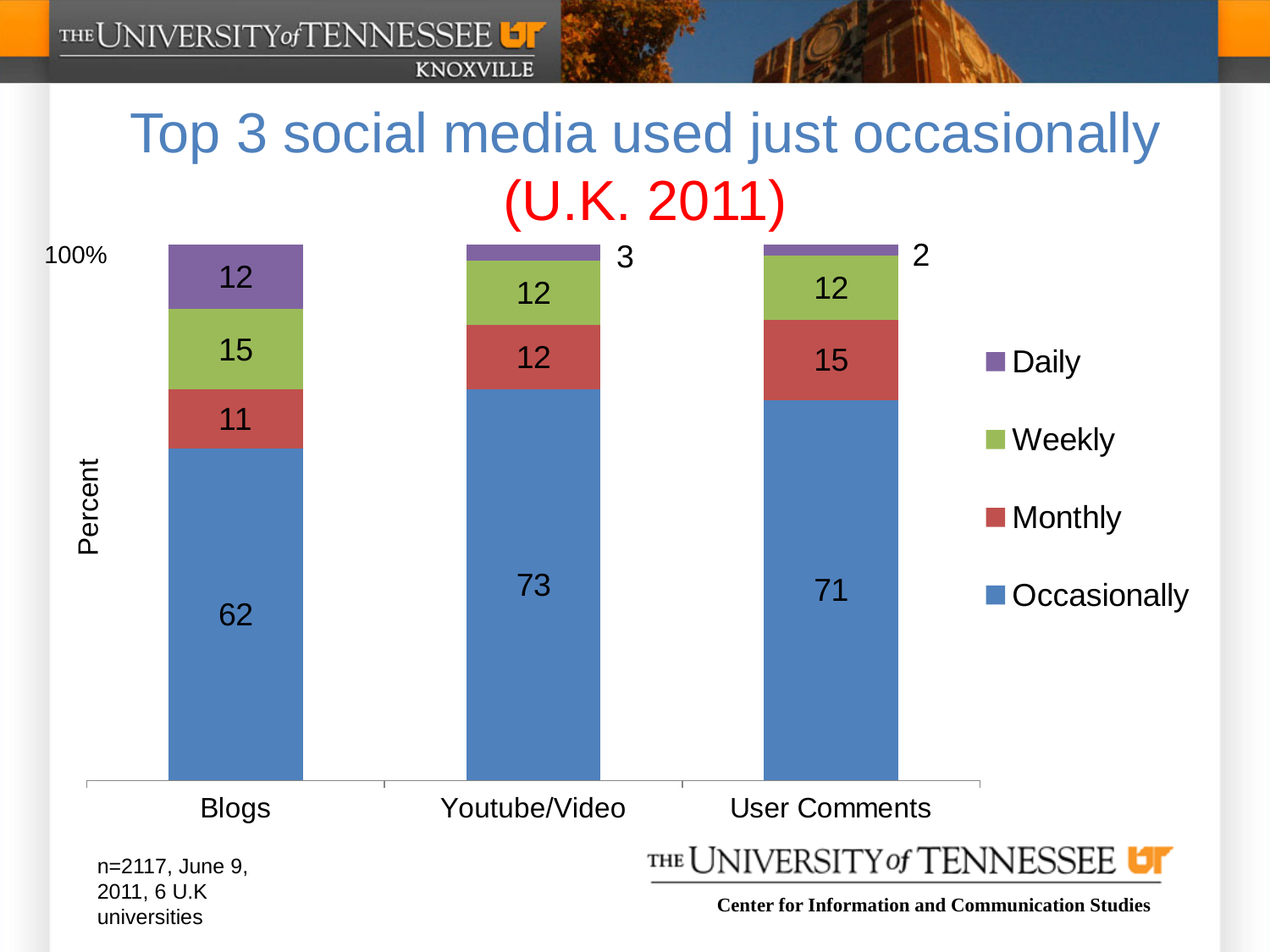
What kind of chart is shown on the slide? Stacked bar chart Which category has the lowest Daily value? User Comments How many categories are shown on the x axis? 3 Which is larger, the Monthly value for Blogs or the Monthly value for Youtube/Video? Youtube/Video What is the total of the stacked bar for User Comments? 100 What is the Daily value for Youtube/Video? 3 How many series does the legend list? 4 What is the Weekly value for Blogs? 15 Which category has the highest Occasionally value? Youtube/Video What is the difference between the Occasionally values for Youtube/Video and Blogs? 11 What is the Occasionally value for Blogs? 62 What is the Monthly value for User Comments? 15